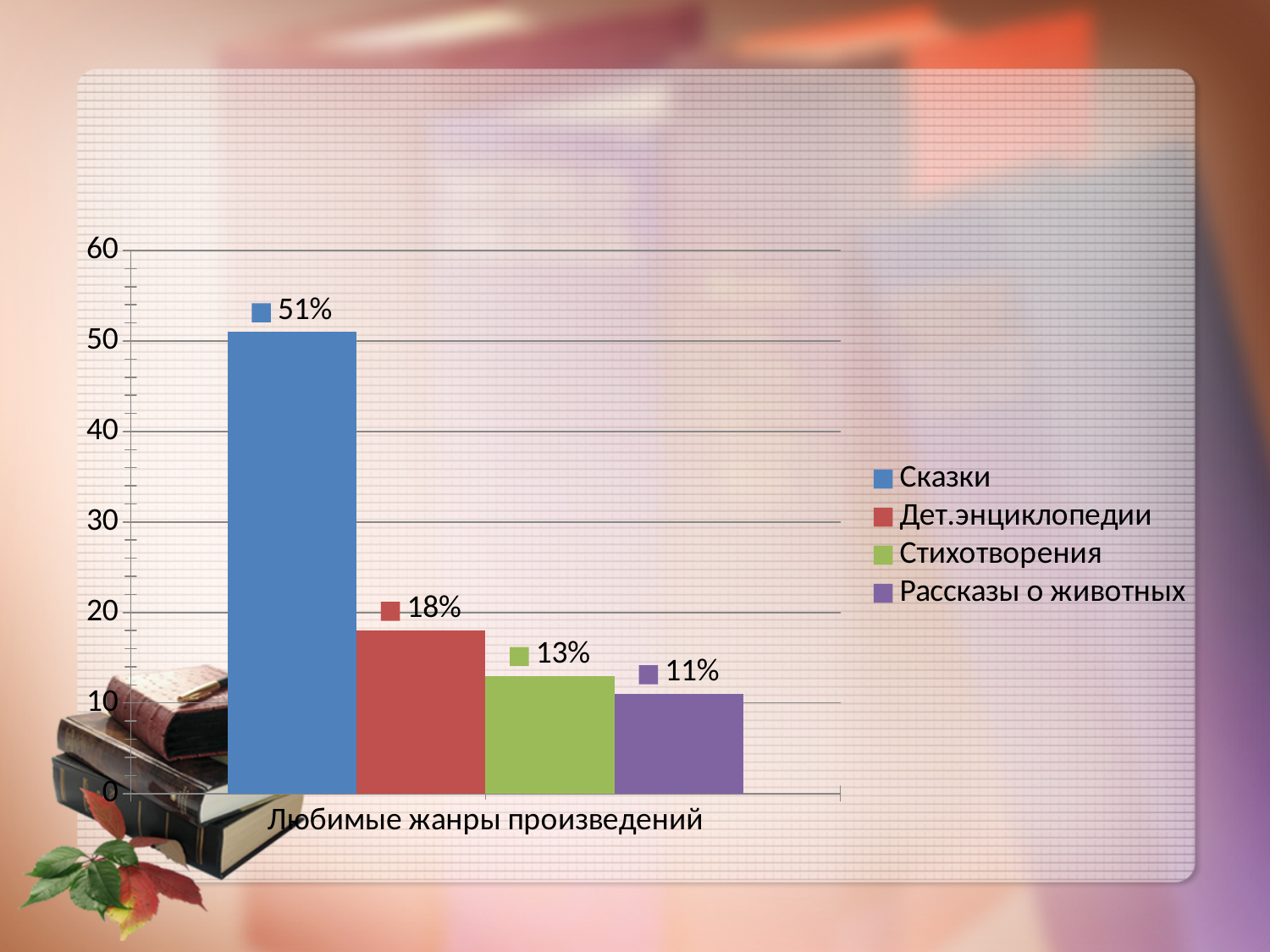
How many series does the legend list? 4 Which series has the highest value? Сказки Which is larger, the value for Стихотворения or the value for Рассказы о животных? Стихотворения Which series has the lowest value? Рассказы о животных What is the value for Рассказы о животных? 11% What is the category label shown on the x axis? Любимые жанры произведений Is the value for Сказки greater or less than 40? greater What is the value for Стихотворения? 13% What kind of chart is shown on the slide? bar chart What is the difference between the values for Сказки and Дет.энциклопедии? 33% What is the value for Дет.энциклопедии? 18% What is the value for Сказки? 51%